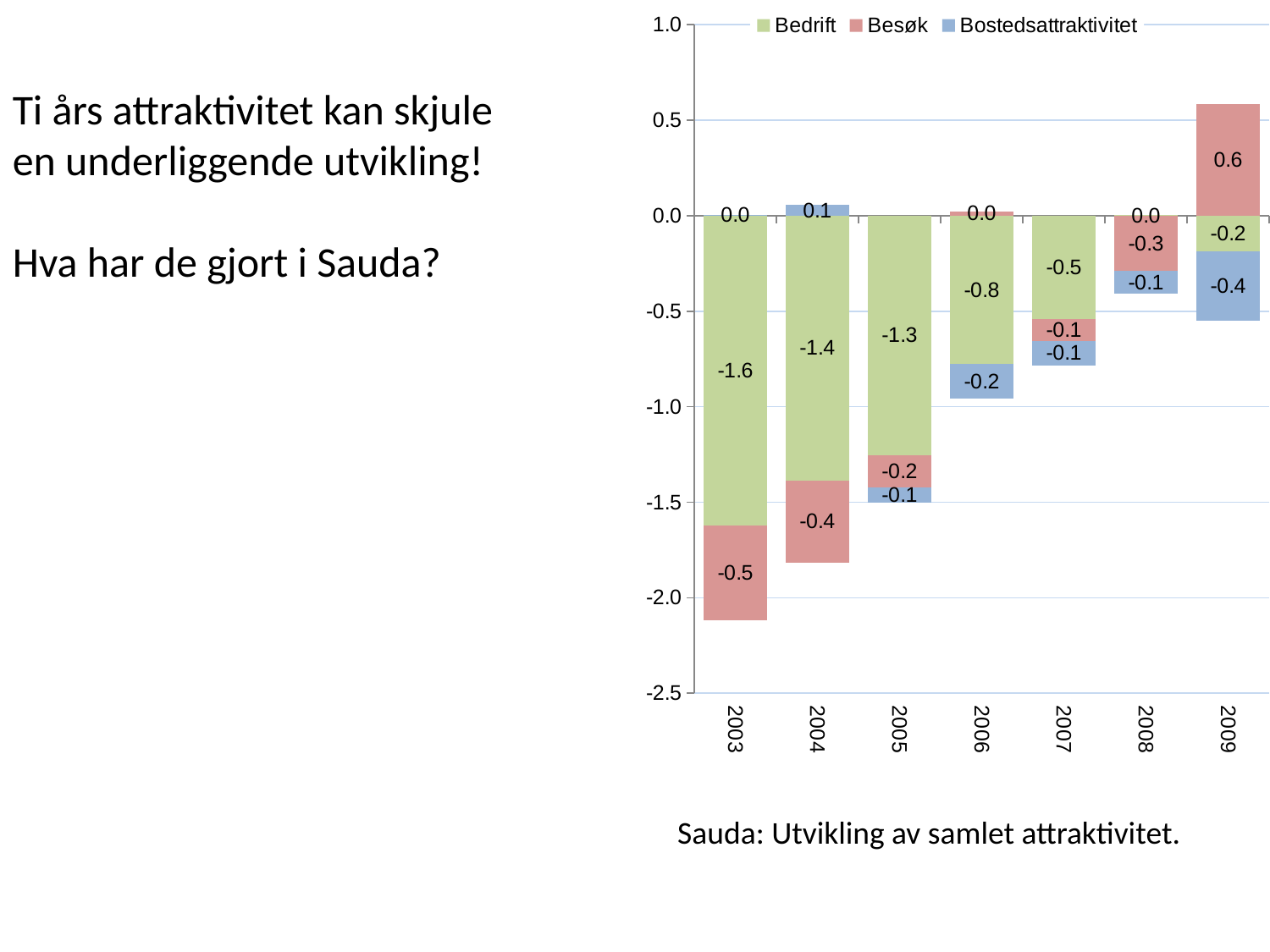
Which is larger, the Bedrift value for 2005 or the Bedrift value for 2007? 2007 What is the Besøk value for 2004? -0.4 What is the Bostedsattraktivitet value for 2006? -0.2 What is the difference between the Bedrift values for 2003 and 2004? 0.2 In which year is the Besøk value highest? 2009 What is the Bedrift value for 2003? -1.6 How many years are shown on the x axis? 7 What is the Besøk value for 2009? 0.6 In which year is the Bedrift value lowest? 2003 What is the total of the stacked bar for 2003? -2.1 What kind of chart is shown on the slide? Stacked bar chart How many series does the legend list? 3